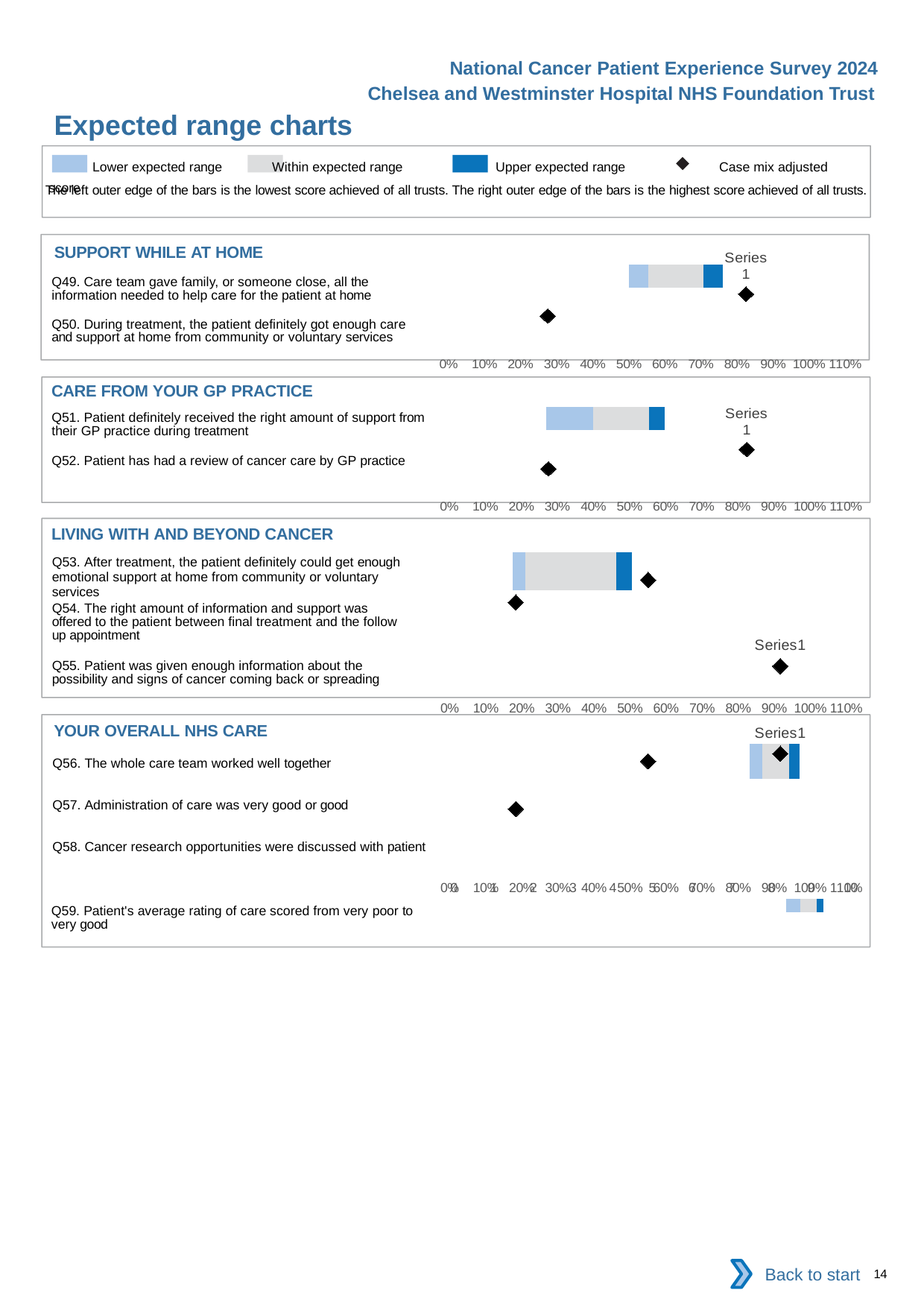
In the SUPPORT WHILE AT HOME chart, is the leftmost diamond marker greater or less than 40%? less In the SUPPORT WHILE AT HOME chart, is the rightmost diamond marker greater or less than 70%? greater How many diamond markers are plotted in the LIVING WITH AND BEYOND CANCER chart? 3 What marker symbol represents the Case mix adjusted score in the legend? diamond What kind of chart is used in the SUPPORT WHILE AT HOME section? bar chart How many questions are listed in the CARE FROM YOUR GP PRACTICE section? 2 How many entries does the legend at the top of the slide list? 4 In the CARE FROM YOUR GP PRACTICE chart, is the leftmost diamond marker greater or less than 40%? less How many questions are listed in the LIVING WITH AND BEYOND CANCER section? 3 What is the highest tick label shown on the x axis of the SUPPORT WHILE AT HOME chart? 110% In the legend, which colour represents the Upper expected range? dark blue